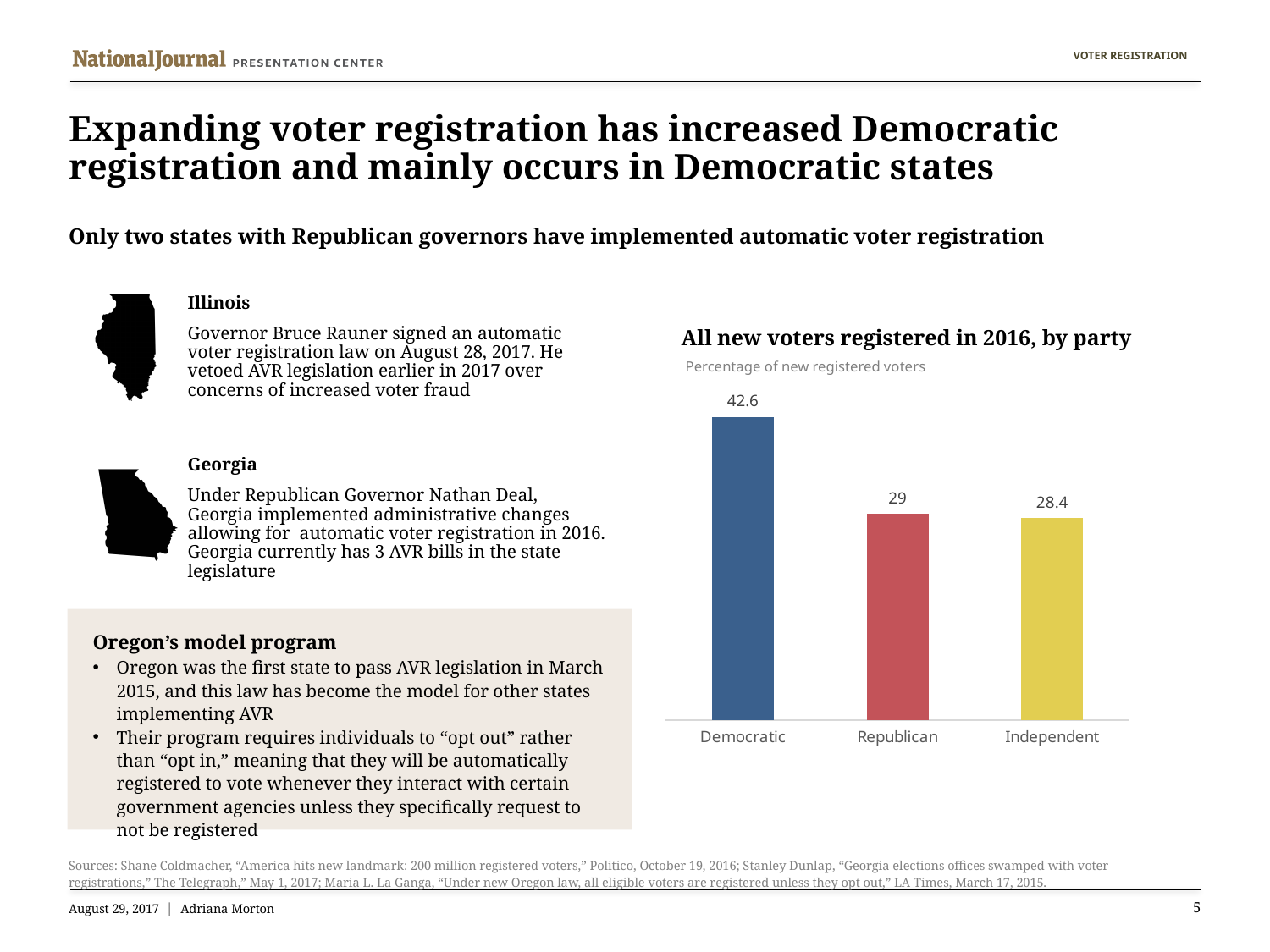
What is the difference between the Republican and Independent percentages of new registered voters? 0.6 What kind of chart is used to show new voters registered in 2016 by party? Bar chart Which party has the lowest percentage of new registered voters in 2016? Independent What colour is the bar for Republican? Red What percentage of new voters registered in 2016 were Republican? 29 How many parties are shown in the chart? 3 What is the difference between the Democratic and Republican percentages of new registered voters? 13.6 Which party has the highest percentage of new registered voters in 2016? Democratic Which is larger, the Democratic or the Independent share of new registered voters? Democratic What percentage of new voters registered in 2016 were Independent? 28.4 What percentage of new voters registered in 2016 were Democratic? 42.6 What is the title of the chart? All new voters registered in 2016, by party